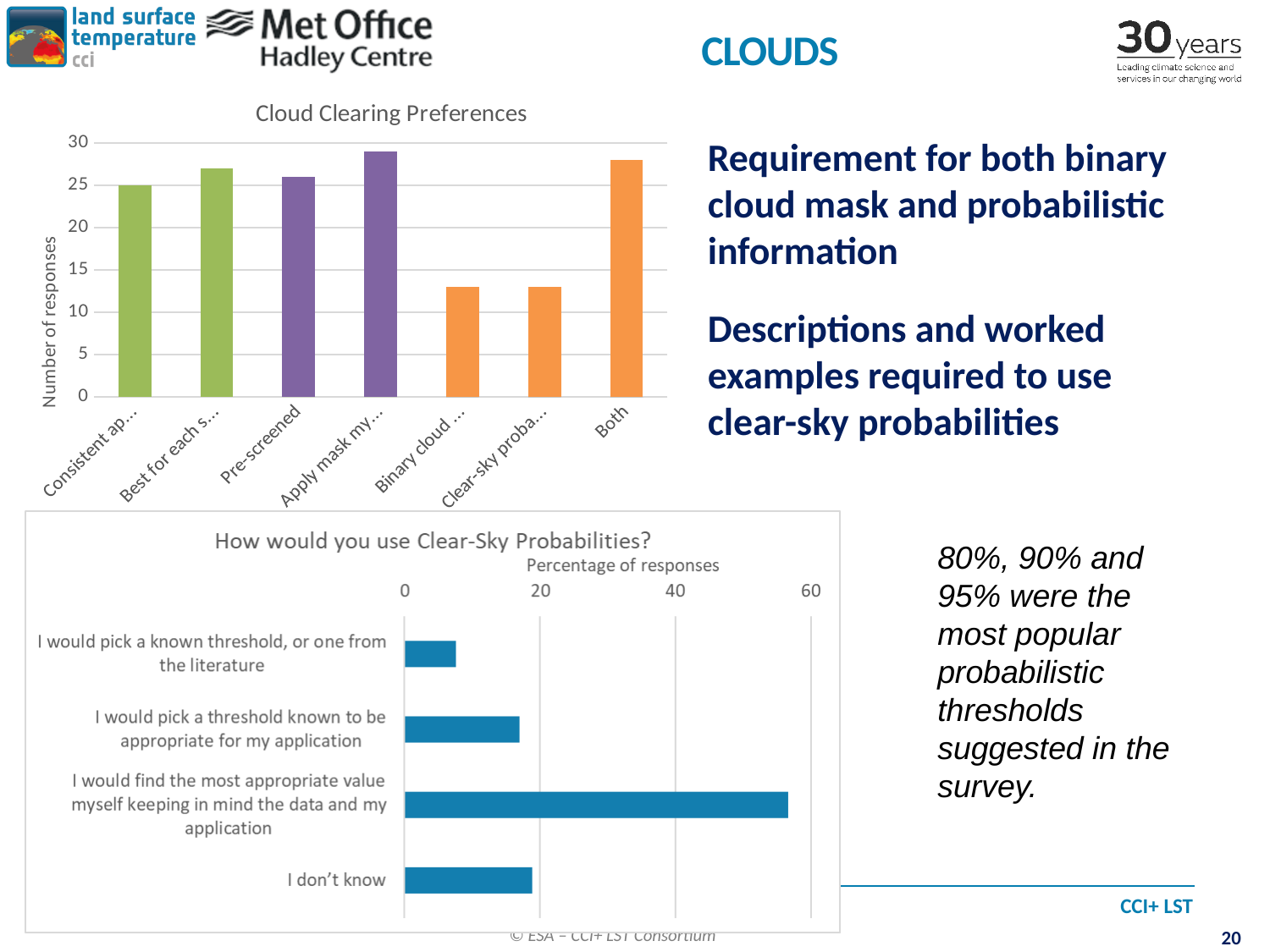
In the "Cloud Clearing Preferences" chart, is the value for "Binary cloud ..." greater or less than 15? less What is the y-axis label of the "Cloud Clearing Preferences" chart? Number of responses In the "Cloud Clearing Preferences" chart, which has more responses, "Pre-screened" or "Binary cloud ..."? Pre-screened How many categories are shown in the "How would you use Clear-Sky Probabilities?" chart? 4 What type of chart is the "Cloud Clearing Preferences" chart? bar chart In the "Cloud Clearing Preferences" chart, is the value for "Both" greater or less than 25? greater In the "How would you use Clear-Sky Probabilities?" chart, which category has the highest percentage of responses? I would find the most appropriate value myself keeping in mind the data and my application In the "How would you use Clear-Sky Probabilities?" chart, is the value for "I would find the most appropriate value myself keeping in mind the data and my application" greater or less than 40? greater In the "How would you use Clear-Sky Probabilities?" chart, which category has the lowest percentage of responses? I would pick a known threshold, or one from the literature In the "How would you use Clear-Sky Probabilities?" chart, which is larger, "I don't know" or "I would pick a known threshold, or one from the literature"? I don't know What type of chart is "How would you use Clear-Sky Probabilities?"? bar chart How many bars are shown in the "Cloud Clearing Preferences" chart? 7